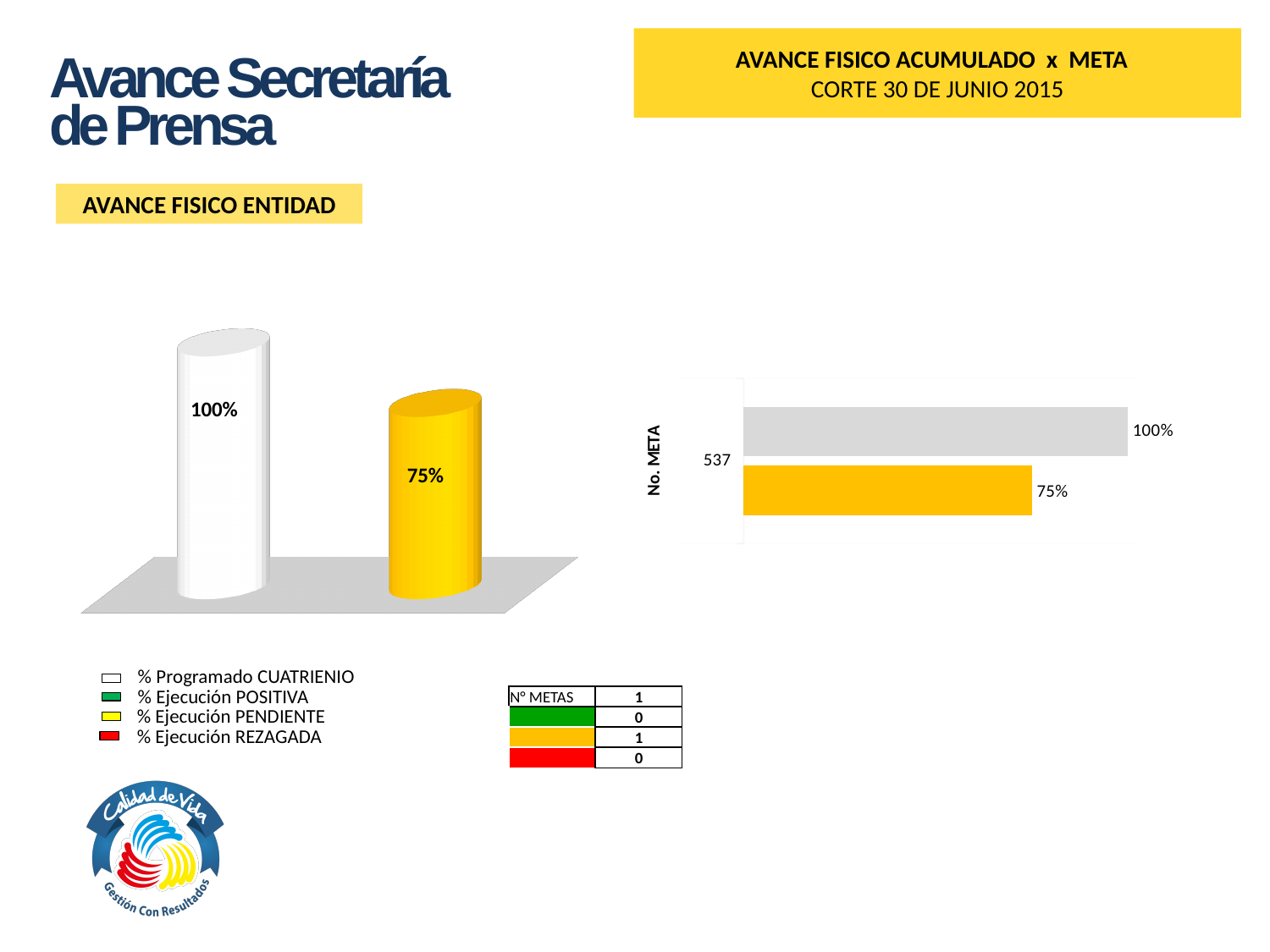
In the AVANCE FISICO ENTIDAD chart, how many bars are plotted? 2 What kind of chart is the AVANCE FISICO ENTIDAD chart? Bar chart What kind of chart is the AVANCE FISICO ACUMULADO x META chart? Bar chart What is the axis title on the vertical axis of the AVANCE FISICO ACUMULADO x META chart? No. META How many entries does the legend at the bottom left of the slide list? 4 In the AVANCE FISICO ENTIDAD chart, what is the value of the yellow bar (% Ejecución PENDIENTE)? 75% In the AVANCE FISICO ENTIDAD chart, what is the difference between the white bar and the yellow bar? 25% In the AVANCE FISICO ACUMULADO x META chart, what is the label of the only category on the vertical axis? 537 In the AVANCE FISICO ENTIDAD chart, which bar is taller, the white one or the yellow one? The white one (100%) In the AVANCE FISICO ACUMULADO x META chart, what is the value of the yellow bar for meta 537? 75% In the AVANCE FISICO ENTIDAD chart, what is the value of the white bar (% Programado CUATRIENIO)? 100% In the AVANCE FISICO ACUMULADO x META chart, what is the value of the grey bar for meta 537? 100%